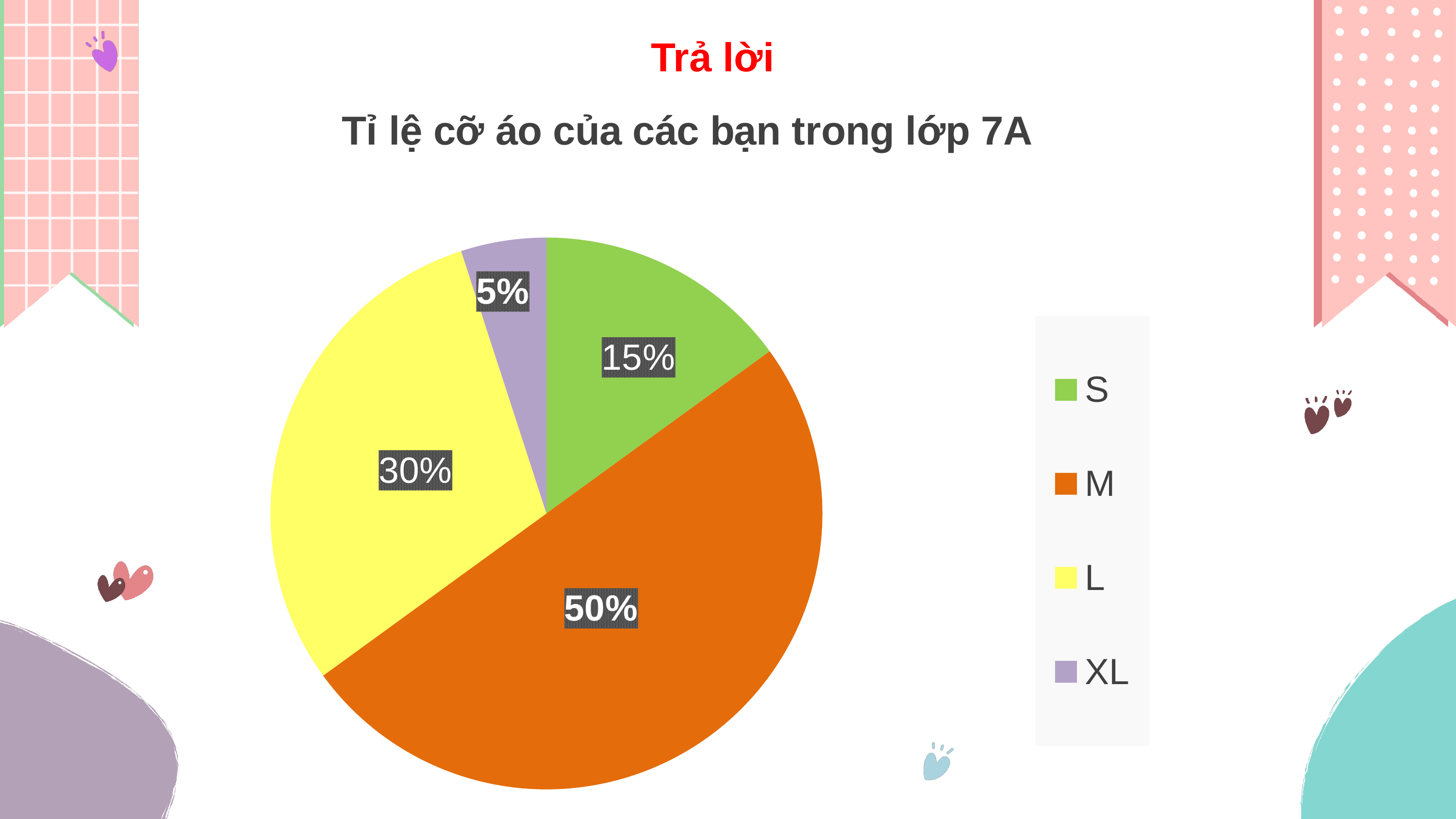
Which shirt size has the smallest share of the pie chart? XL What colour represents size L in the pie chart? yellow Which has a larger share, size S or size L? L What is the title of the chart? Tỉ lệ cỡ áo của các bạn trong lớp 7A Which shirt size has the largest share of the pie chart? M What type of chart is shown on the slide? pie chart What percentage of the pie chart is size M? 50% What percentage of the pie chart is size L? 30% What percentage of the pie chart is size XL? 5% What is the difference in percentage points between size M and size L? 20 How many shirt sizes are shown in the pie chart? 4 What percentage of the pie chart is size S? 15%